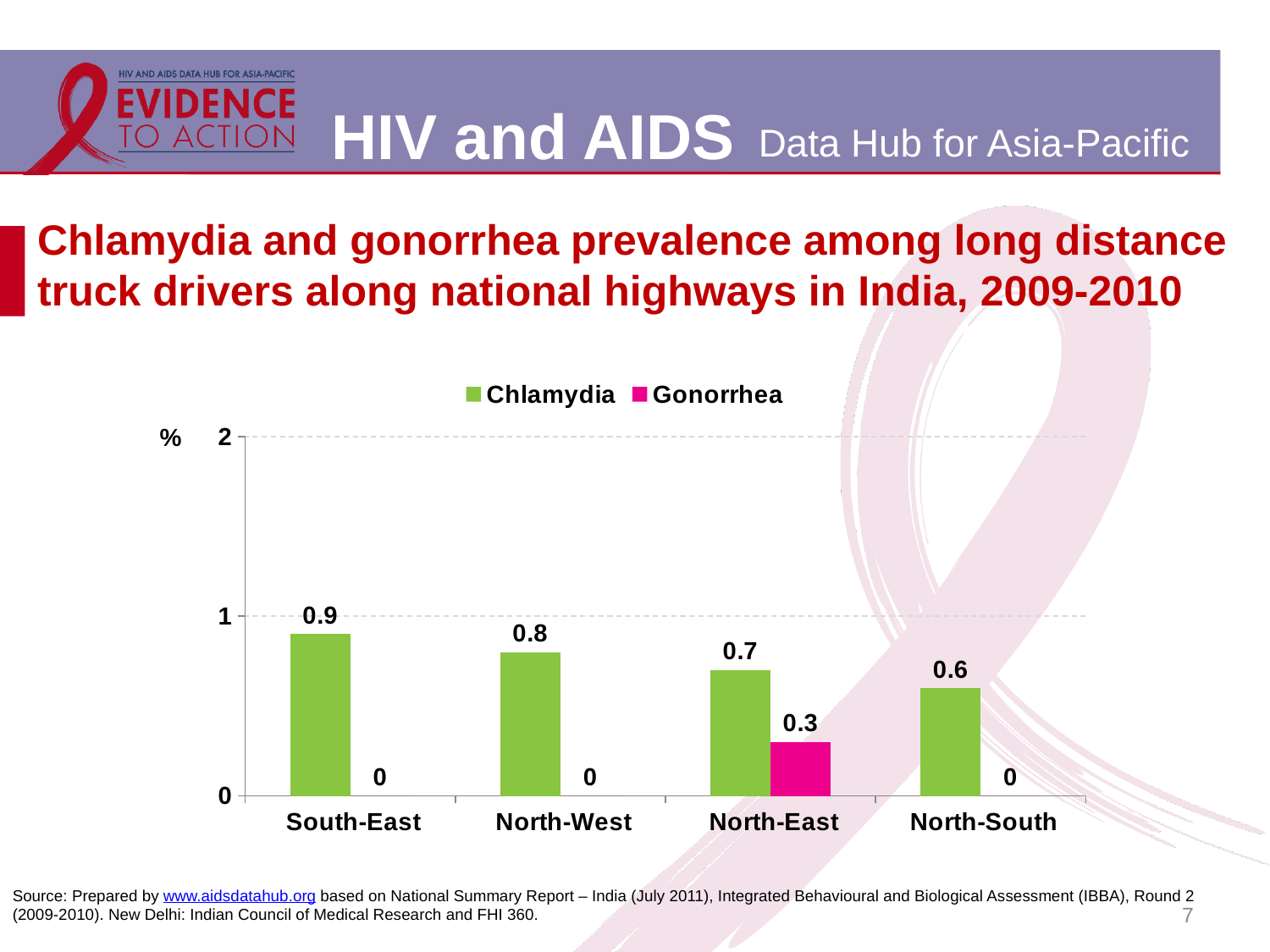
Is the Chlamydia value for North-West greater or less than 1? less What is the Gonorrhea prevalence for North-East? 0.3 What is the Gonorrhea prevalence for North-West? 0 What kind of chart is shown on the slide? bar chart How many series does the legend list? 2 How many routes are shown on the x axis? 4 What is the Chlamydia prevalence for South-East? 0.9 For North-East, which is larger: Chlamydia or Gonorrhea prevalence? Chlamydia Which route has the lowest Chlamydia prevalence? North-South What is the Chlamydia prevalence for North-South? 0.6 Which route has the highest Chlamydia prevalence? South-East What is the difference between the Chlamydia prevalence for South-East and North-South? 0.3